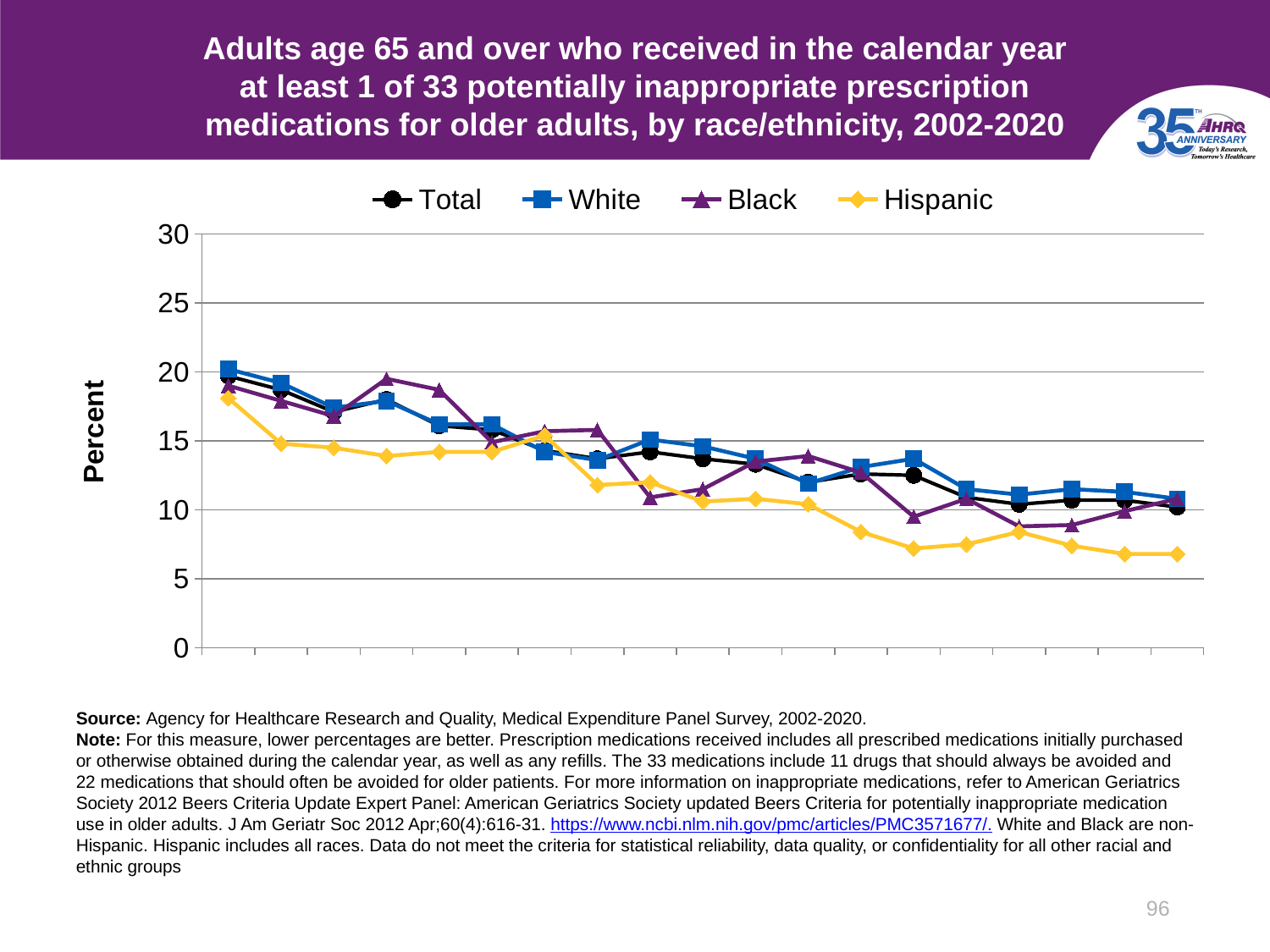
Do the values for the Total series rise or fall from 2002 to 2020? fall Is the value for Hispanic in the first year shown (2002) greater or less than 15? greater Which series are listed in the legend? Total, White, Black, Hispanic Do the values for the Hispanic series generally rise or fall across the years shown? fall What kind of chart is shown on the slide? line chart How many data points does each series have along the x axis? 19 Is the value for Hispanic in the last year shown (2020) greater or less than 10? less In the first year shown (2002), which is larger, the value for White or the value for Hispanic? White What is the label on the vertical axis? Percent Is the value for White in the last year shown (2020) greater or less than 15? less How many series does the legend list? 4 Which series has the lowest value in the last year shown (2020)? Hispanic